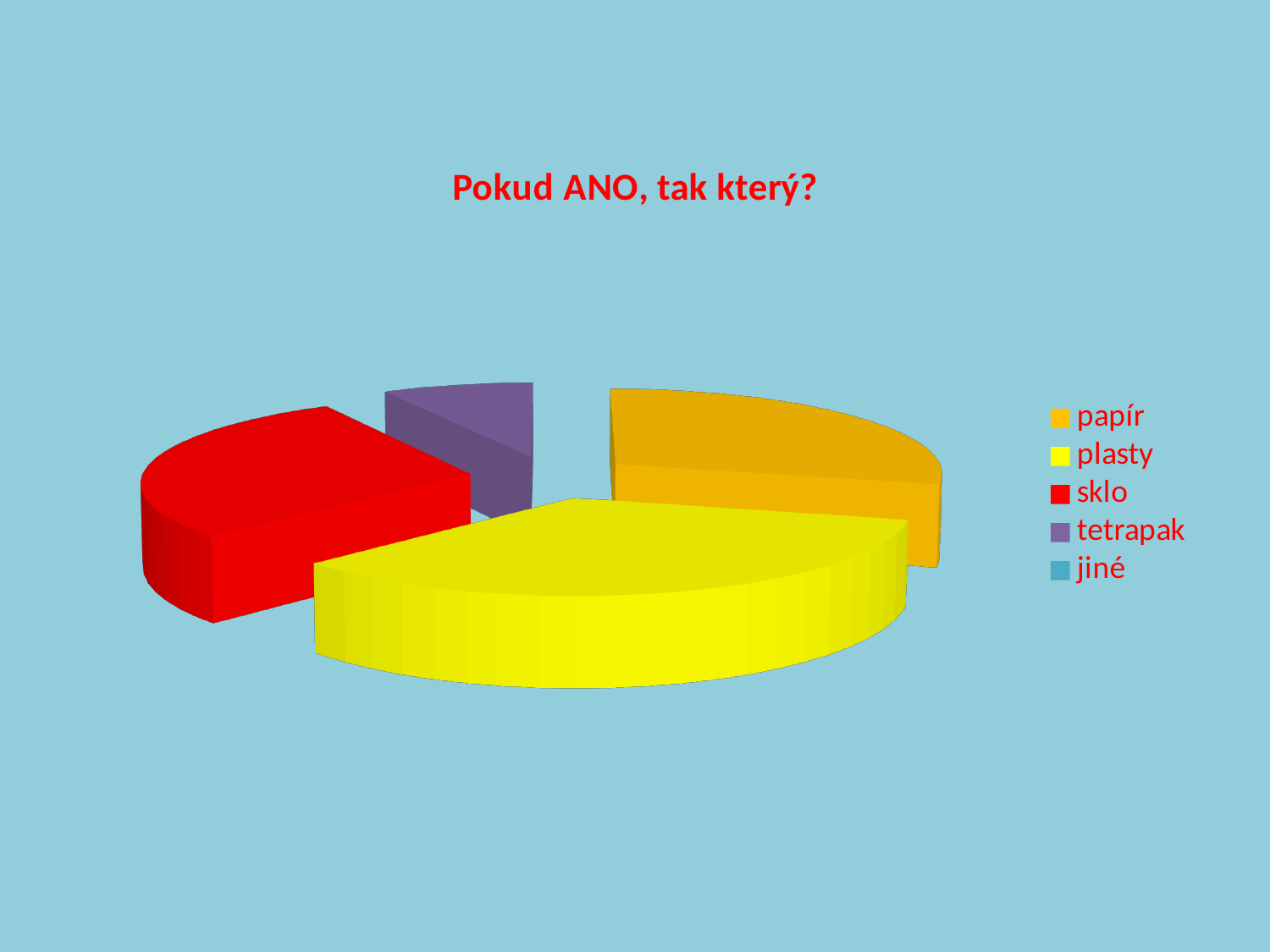
Which slice is larger, plasty or sklo? plasty Which slice is larger, plasty or papír? plasty Which colour represents the category sklo in the pie chart? red Which category has the largest slice of the pie chart? plasty Which slice is larger, papír or tetrapak? papír How many categories does the legend of the pie chart list? 5 What kind of chart is shown on the slide? pie chart What is the title of the chart? Pokud ANO, tak který?